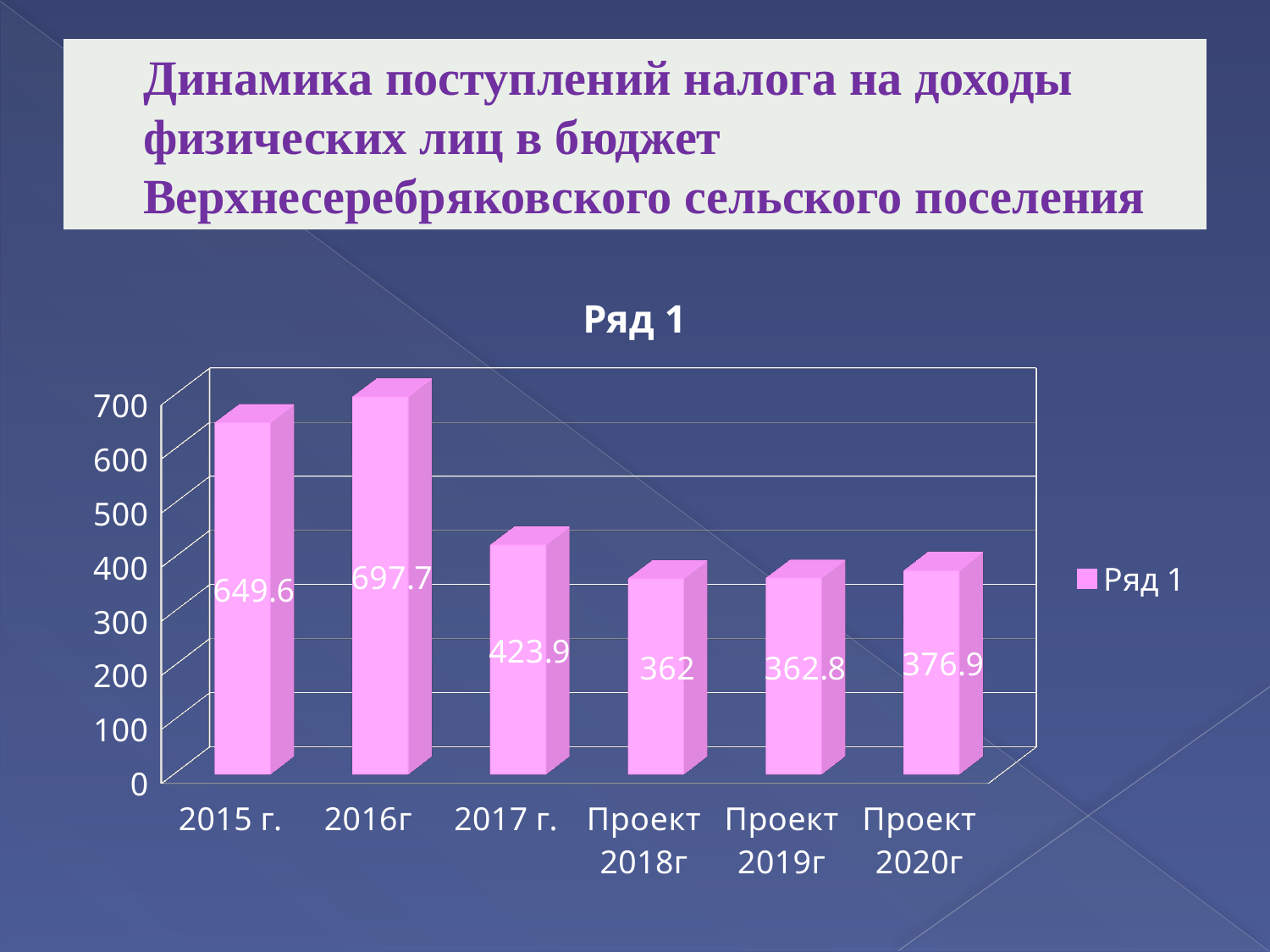
Which category has the lowest value? Проект 2018г What is the value for Проект 2018г? 362 What is the value for 2016г? 697.7 What is the value for 2015 г.? 649.6 What kind of chart is shown on the slide? bar chart What is the title of the chart? Ряд 1 How many categories are shown on the x axis? 6 How many series does the legend list? 1 Which is larger, the value for 2017 г. or the value for Проект 2020г? 2017 г. Is the value for Проект 2019г greater or less than 400? less What is the difference between the values for 2016г and 2015 г.? 48.1 Which category has the highest value? 2016г